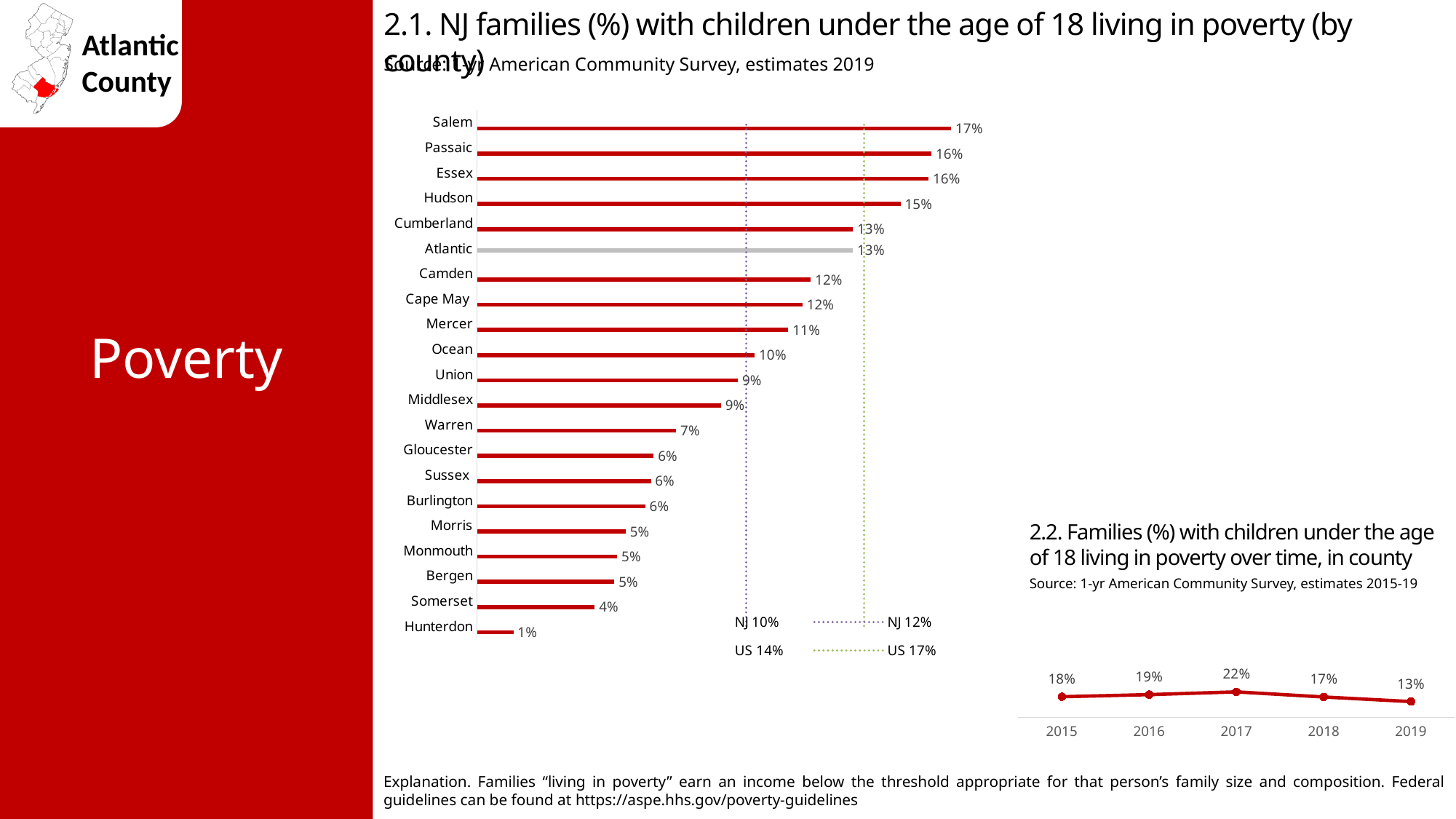
In chart 2.1 (by county), which is larger, the value for Camden or the value for Warren? Camden In chart 2.1 (by county), which county has the highest value? Salem What kind of chart is chart 2.1 (by county)? Bar chart In chart 2.2 (over time, in county), what is the difference between the values for 2017 and 2019? 9% In chart 2.1 (by county), what is the value for Hudson? 15% In chart 2.2 (over time, in county), which year has the lowest value? 2019 In chart 2.1 (by county), what is the difference between the values for Salem and Hunterdon? 16% In chart 2.1 (by county), which county has the lowest value? Hunterdon In chart 2.1 (by county), what is the value for Somerset? 4% In chart 2.1 (NJ families with children under 18 living in poverty by county), what is the value for Atlantic? 13% In chart 2.2 (families in poverty over time, in county), what is the value for 2017? 22% In chart 2.1 (by county), how many counties are plotted? 21